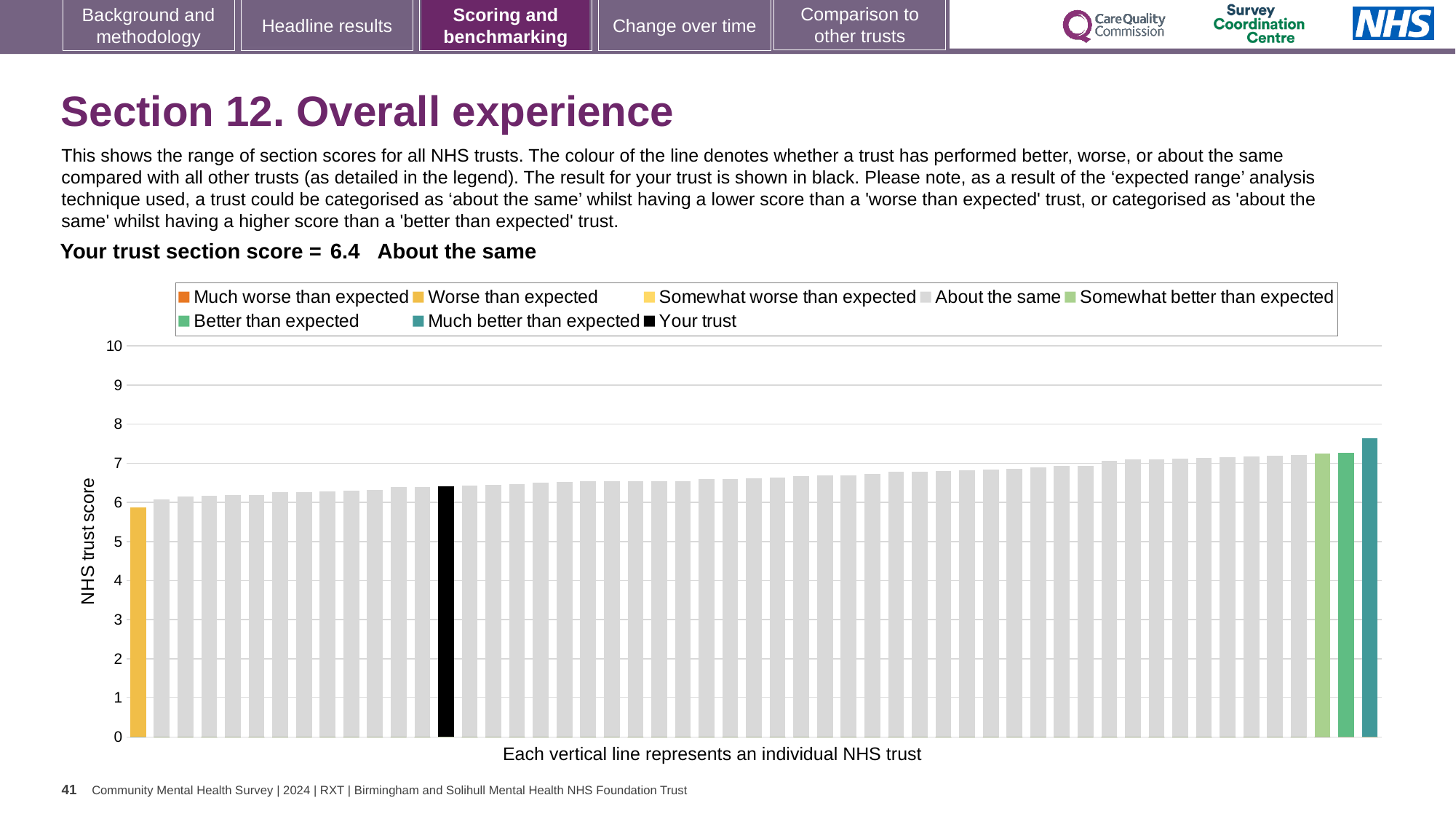
How many entries does the chart legend list? 8 Is the value of the tallest bar greater or less than 8? less Which legend category does the highest bar on the chart belong to? Much better than expected Which category is your trust placed in for this section? About the same Which legend category does the lowest bar on the chart belong to? Worse than expected Is the value of the tallest bar (Much better than expected) greater or less than 7? greater What kind of chart is shown on the slide? bar chart Is the value of the leftmost (Worse than expected) bar greater or less than 7? less What is the section score for your trust shown on the slide? 6.4 Do the bar values rise or fall from left to right across the chart? rise How many bars are coloured as 'Somewhat better than expected'? 1